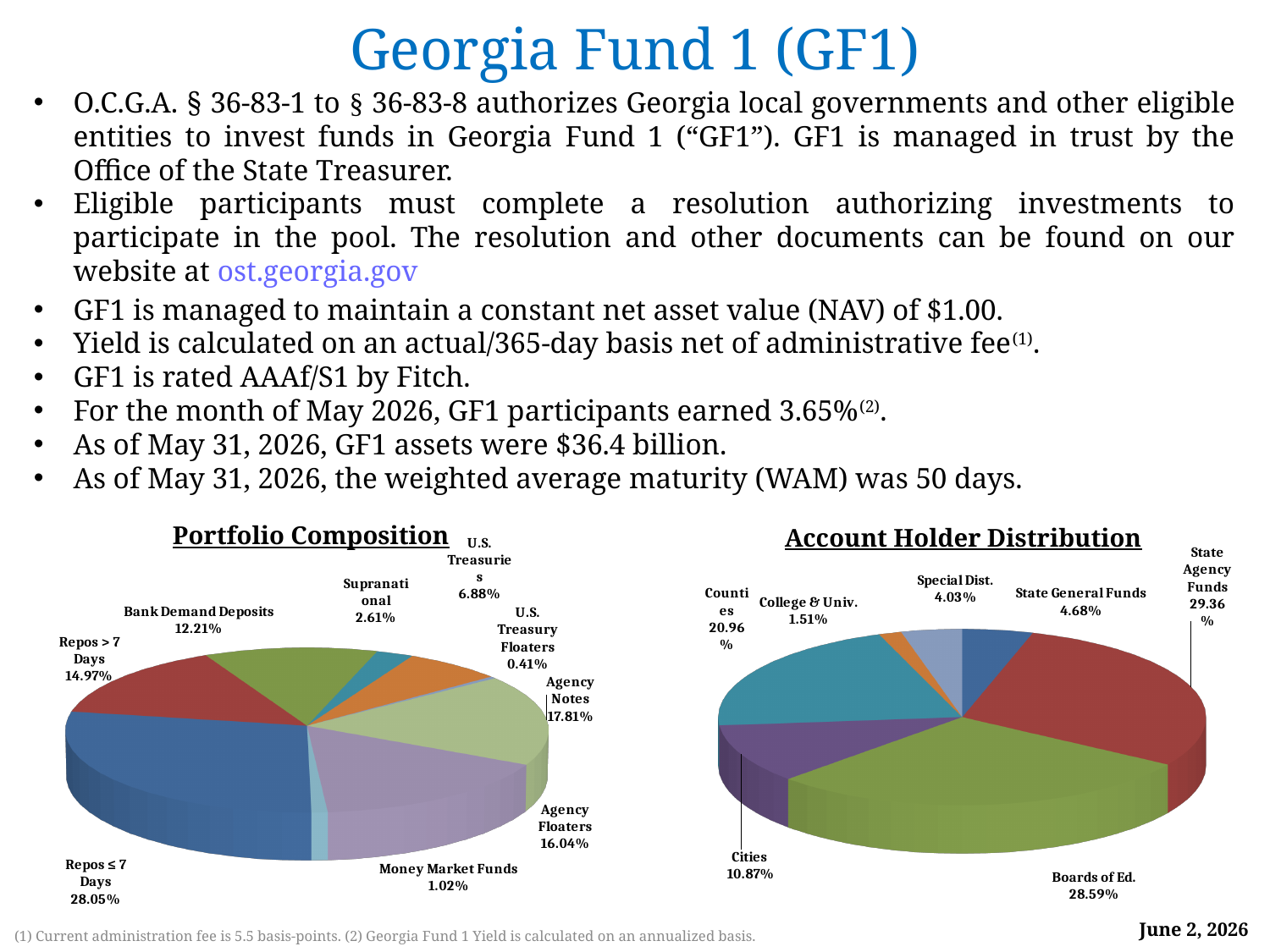
In the Account Holder Distribution chart, what percentage is Counties? 20.96% In the Portfolio Composition chart, which category has the largest share? Repos ≤ 7 Days In the Account Holder Distribution chart, how many categories are shown? 7 What type of chart is the Account Holder Distribution chart? Pie chart In the Portfolio Composition chart, which category has the smallest share? U.S. Treasury Floaters In the Account Holder Distribution chart, which is larger, Cities or State General Funds? Cities In the Portfolio Composition chart, what percentage is Agency Notes? 17.81% In the Account Holder Distribution chart, what share is held by Boards of Ed.? 28.59% In the Portfolio Composition chart, what is the difference between Bank Demand Deposits and U.S. Treasuries? 5.33% In the Portfolio Composition chart, what share of the portfolio is Repos ≤ 7 Days? 28.05% In the Portfolio Composition chart, how many categories are shown? 9 In the Account Holder Distribution chart, which category has the smallest share? College & Univ.